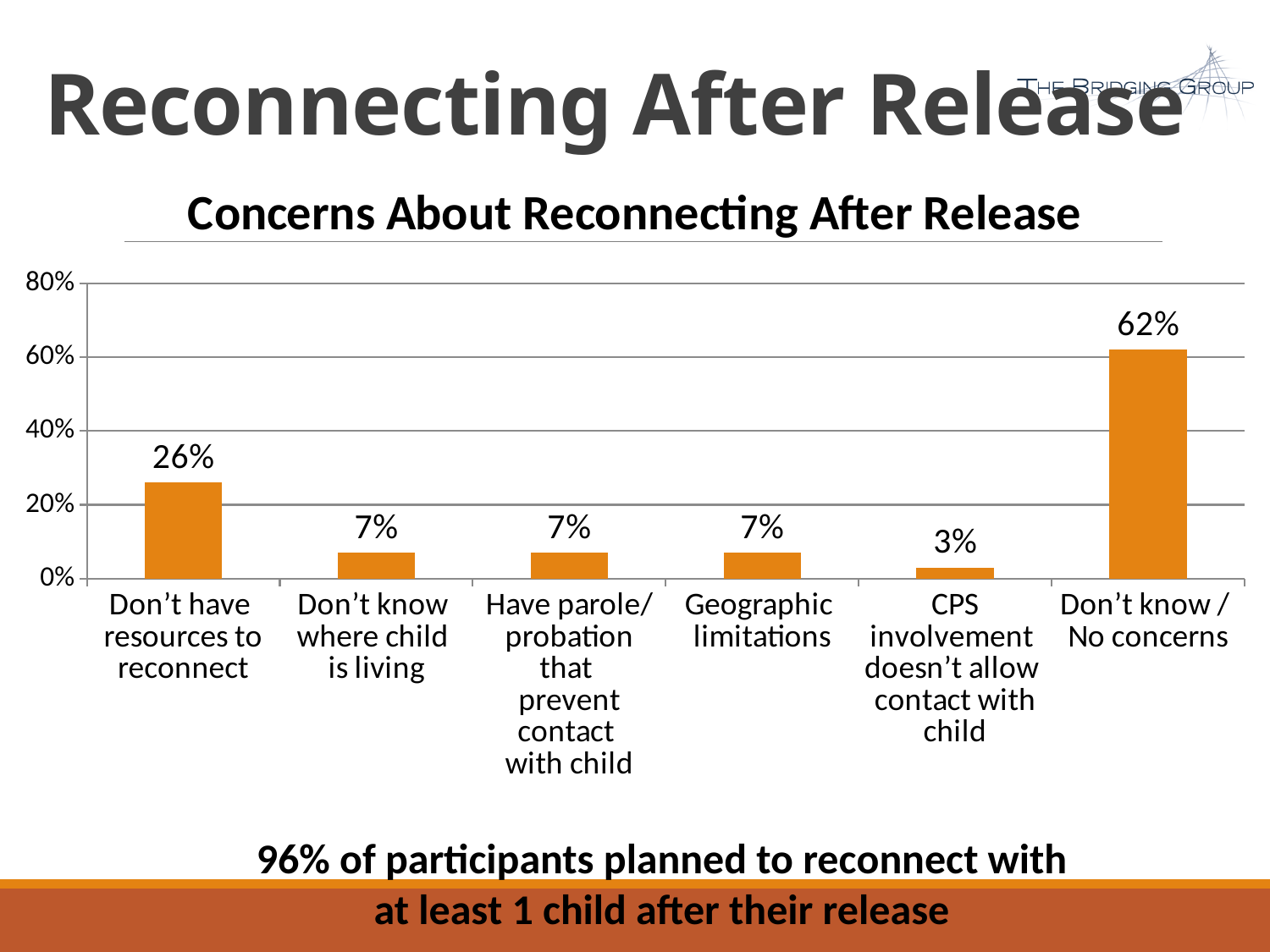
Which category has the highest value? Don't know / No concerns What kind of chart is shown? Bar chart What is the difference between "Don't know / No concerns" and "Don't have resources to reconnect"? 36% Which is larger, "Don't have resources to reconnect" or "Don't know where child is living"? Don't have resources to reconnect What is the value for "Don't have resources to reconnect"? 26% What is the value for "Geographic limitations"? 7% How many categories are shown on the chart? 6 Which category has the lowest value? CPS involvement doesn't allow contact with child What is the value for "Don't know / No concerns"? 62% What is the title of the chart? Concerns About Reconnecting After Release What is the value for "CPS involvement doesn't allow contact with child"? 3% Is the value for "Don't know / No concerns" greater or less than 40%? greater